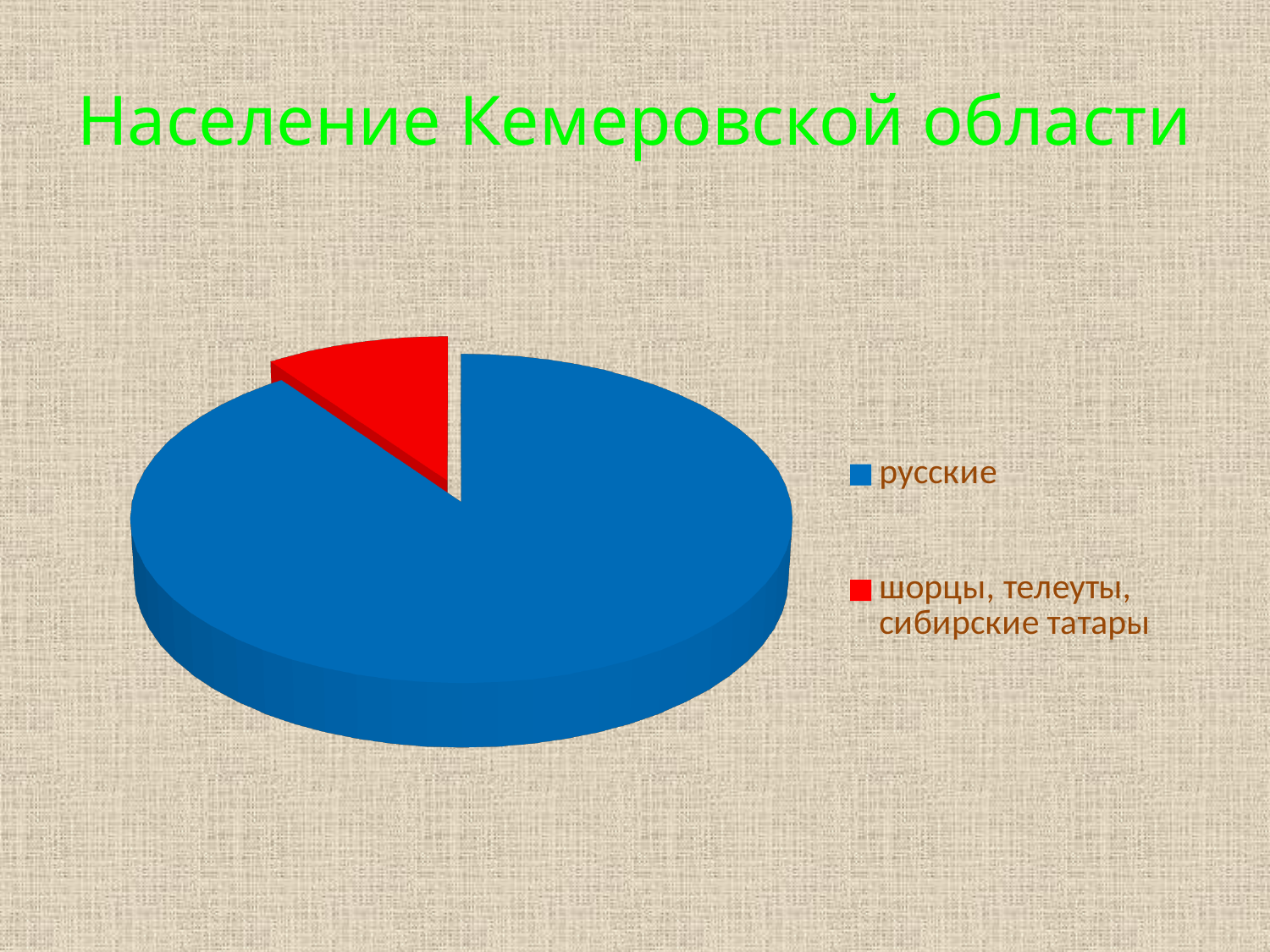
What kind of chart is shown on the slide? pie chart Which category has the smallest slice of the pie? шорцы, телеуты, сибирские татары What colour is the slice for русские? blue Which category has the largest slice of the pie? русские How many entries does the legend list? 2 What is the title of the chart on the slide? Население Кемеровской области Which slice is larger: русские or шорцы, телеуты, сибирские татары? русские How many slices does the pie chart have? 2